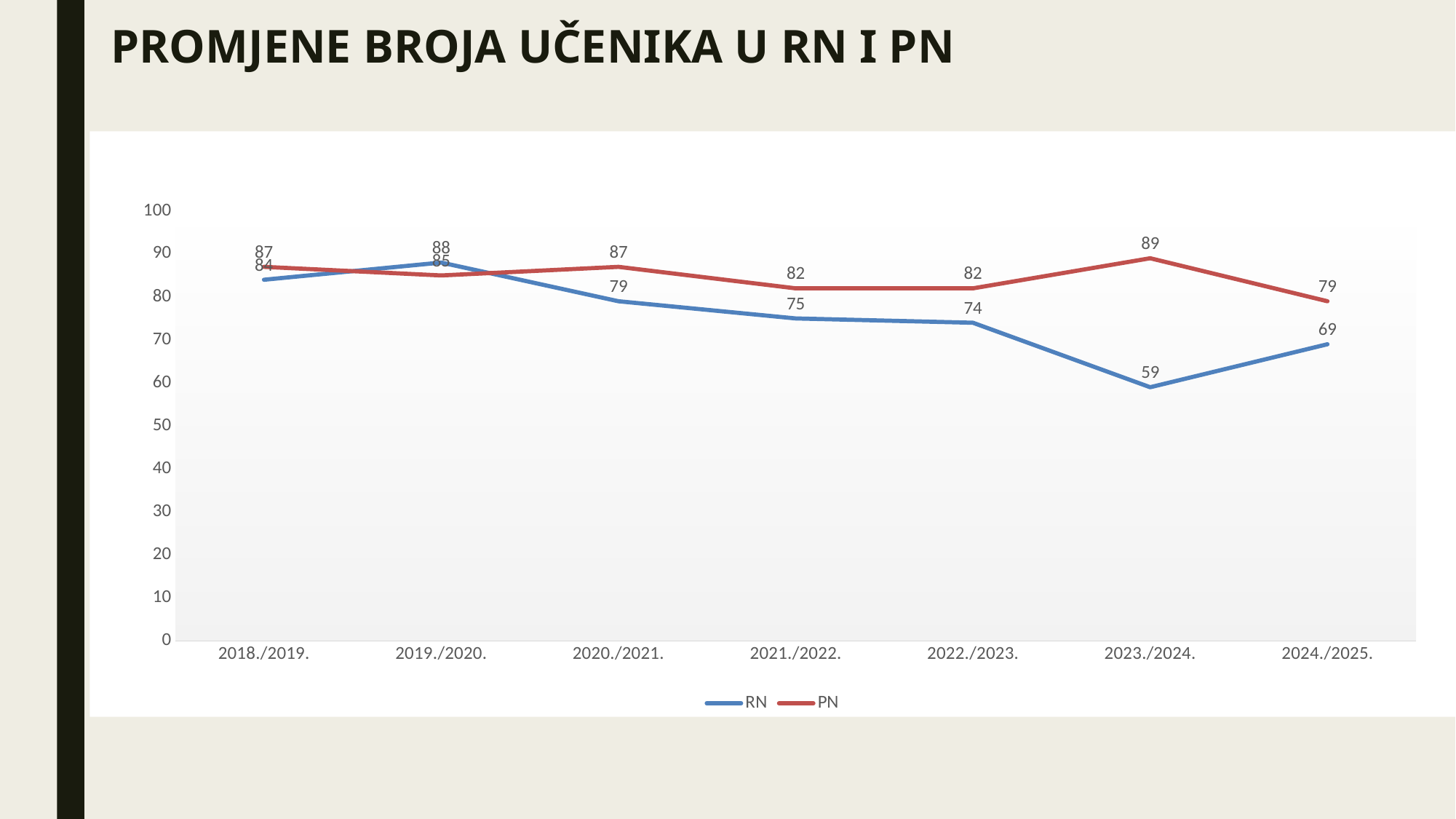
What is the value for RN in 2023./2024.? 59 In which school year is the RN value lowest? 2023./2024. How many school years are plotted on the x axis? 7 What is the value for PN in 2024./2025.? 79 What is the difference between PN and RN in 2023./2024.? 30 How many series does the legend list? 2 What colour is the PN line? red Which is larger in 2019./2020., RN or PN? RN In which school year is the PN value highest? 2023./2024. What type of chart is shown on the slide? line chart What is the value for RN in 2019./2020.? 88 Does the RN line rise or fall from 2019./2020. to 2023./2024.? fall